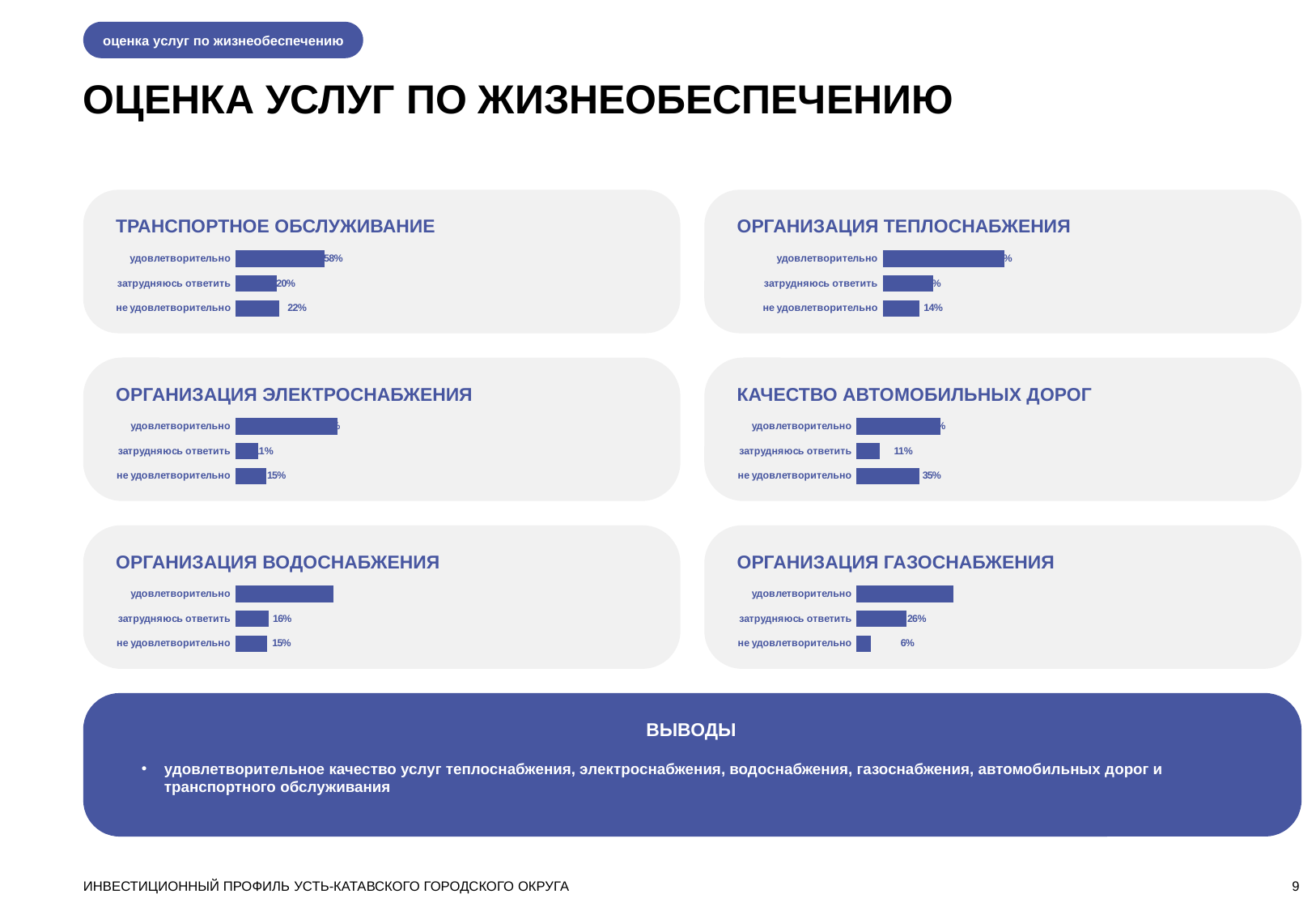
In the 'ОРГАНИЗАЦИЯ ЭЛЕКТРОСНАБЖЕНИЯ' chart, which category has the highest value? удовлетворительно In the 'КАЧЕСТВО АВТОМОБИЛЬНЫХ ДОРОГ' chart, what is the difference between 'не удовлетворительно' and 'затрудняюсь ответить'? 24% How many categories does the 'ОРГАНИЗАЦИЯ ВОДОСНАБЖЕНИЯ' chart show? 3 In the 'ОРГАНИЗАЦИЯ ГАЗОСНАБЖЕНИЯ' chart, which is larger: 'затрудняюсь ответить' or 'не удовлетворительно'? затрудняюсь ответить In the 'ОРГАНИЗАЦИЯ ТЕПЛОСНАБЖЕНИЯ' chart, what is the value for 'не удовлетворительно'? 14% In the 'ОРГАНИЗАЦИЯ ГАЗОСНАБЖЕНИЯ' chart, which category has the lowest value? не удовлетворительно In the 'ТРАНСПОРТНОЕ ОБСЛУЖИВАНИЕ' chart, what is the value for 'не удовлетворительно'? 22% In the 'ОРГАНИЗАЦИЯ ГАЗОСНАБЖЕНИЯ' chart, what is the value for 'затрудняюсь ответить'? 26% In the 'ОРГАНИЗАЦИЯ ВОДОСНАБЖЕНИЯ' chart, what is the value for 'затрудняюсь ответить'? 16% In the 'КАЧЕСТВО АВТОМОБИЛЬНЫХ ДОРОГ' chart, what is the value for 'не удовлетворительно'? 35% In the 'КАЧЕСТВО АВТОМОБИЛЬНЫХ ДОРОГ' chart, which category has the lowest value? затрудняюсь ответить In the 'ТРАНСПОРТНОЕ ОБСЛУЖИВАНИЕ' chart, what is the value for 'удовлетворительно'? 58%